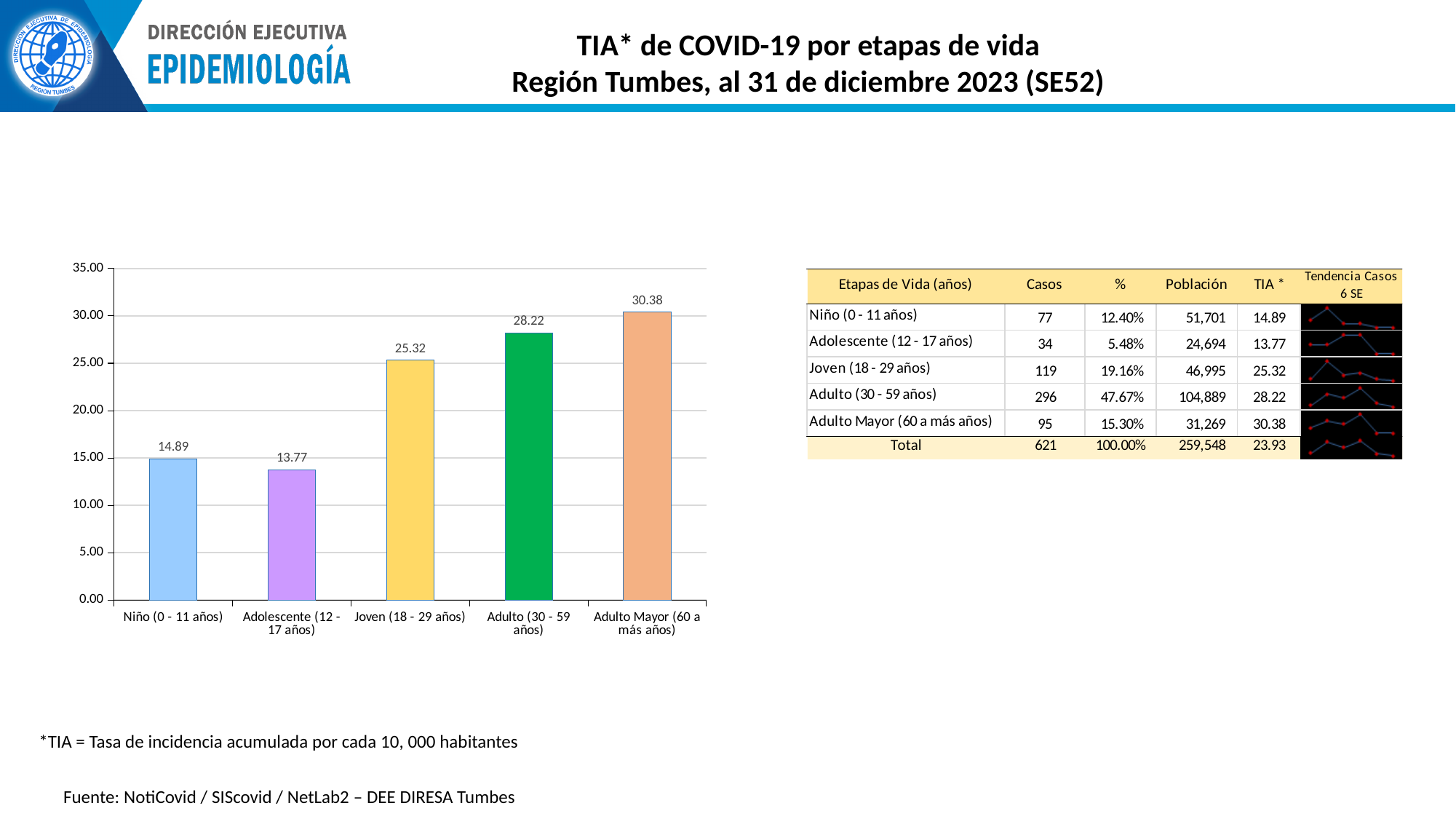
Which has a higher TIA, Niño (0 - 11 años) or Adolescente (12 - 17 años)? Niño (0 - 11 años) What is the TIA value for Niño (0 - 11 años) in the bar chart? 14.89 What is the TIA value for Adulto Mayor (60 a más años) in the bar chart? 30.38 From Adolescente (12 - 17 años) to Adulto Mayor (60 a más años), do the TIA values rise or fall along the x axis? rise Which age group has the highest TIA in the bar chart? Adulto Mayor (60 a más años) What colour is the bar for Adulto (30 - 59 años)? green What is the TIA value for Joven (18 - 29 años) in the bar chart? 25.32 Is the TIA value for Adulto (30 - 59 años) greater or less than 25.00? greater What is the difference between the TIA for Adulto Mayor (60 a más años) and Adulto (30 - 59 años)? 2.16 How many age groups are shown in the bar chart? 5 Which age group has the lowest TIA in the bar chart? Adolescente (12 - 17 años) What kind of chart is used to show TIA by age group? bar chart